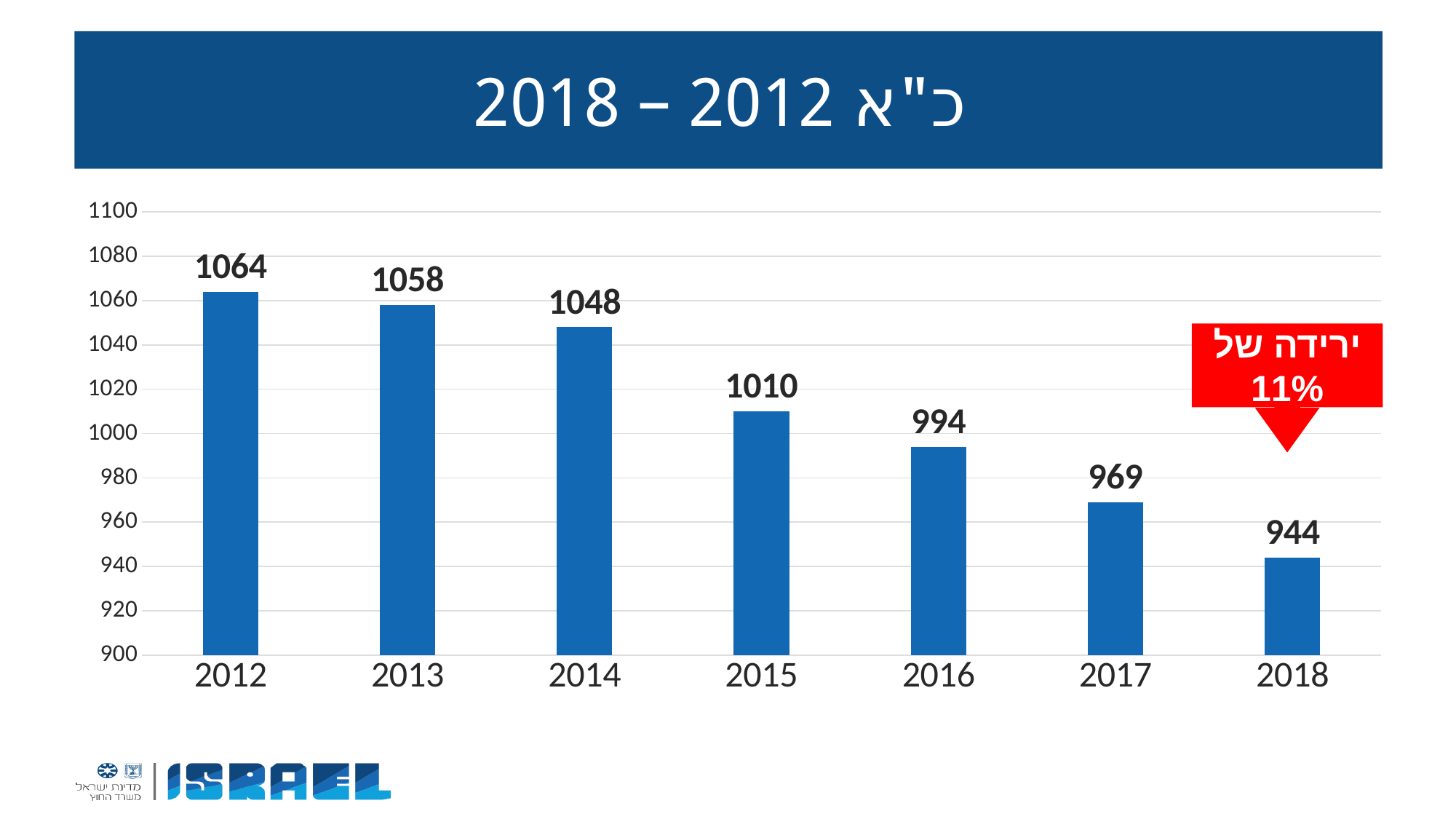
How many years are shown on the x axis? 7 What kind of chart is shown on the slide? bar chart What is the value for 2015? 1010 Is the value for 2017 greater or less than 1000? less What is the value for 2018? 944 What is the difference between the values for 2016 and 2017? 25 Which is larger, the value for 2014 or the value for 2016? 2014 Do the values rise or fall from 2012 to 2018? fall Which year has the lowest value? 2018 What is the value for 2012? 1064 Which year has the highest value? 2012 What is the difference between the values for 2012 and 2018? 120